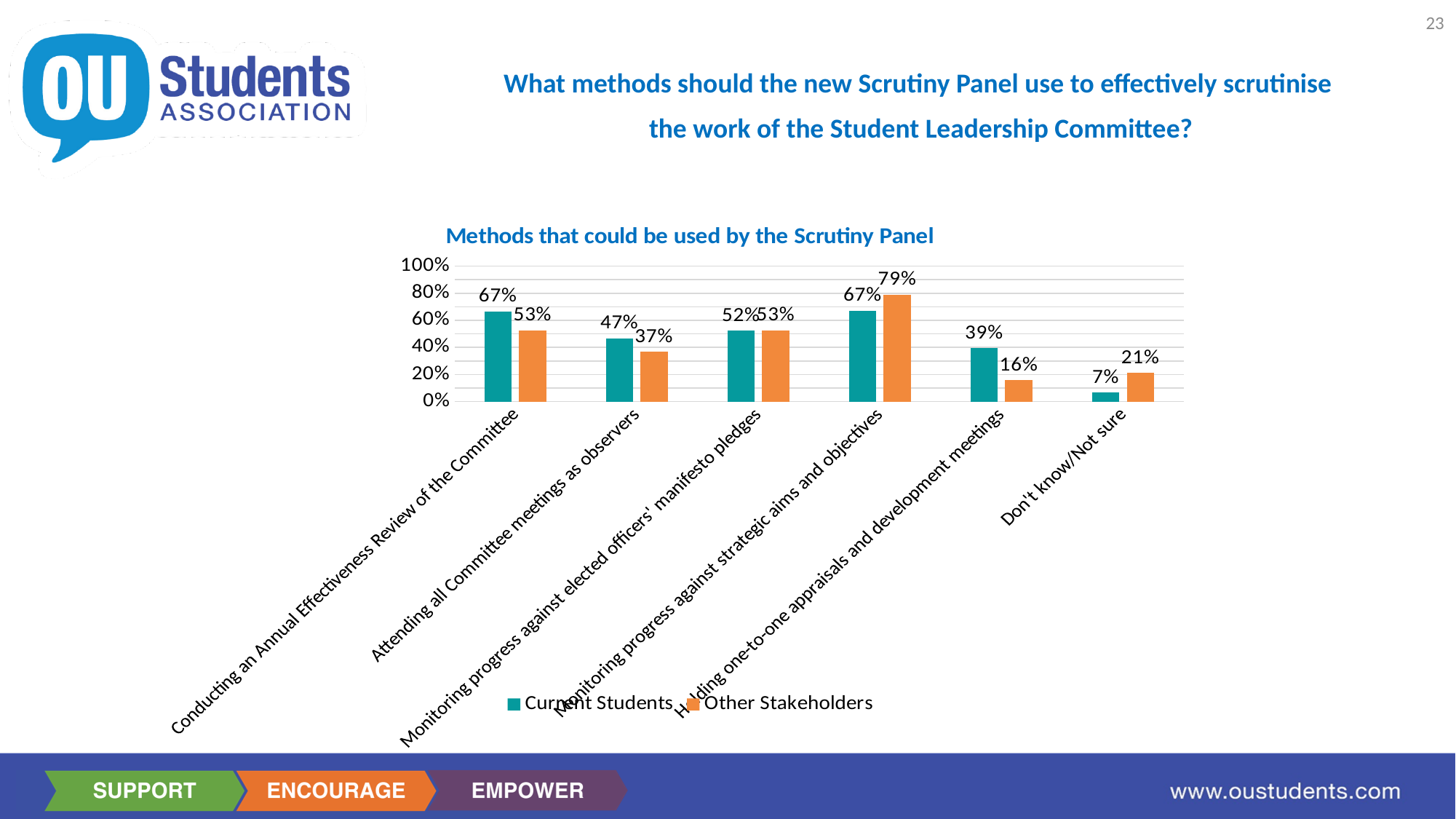
For 'Conducting an Annual Effectiveness Review of the Committee', which group has the higher value, Current Students or Other Stakeholders? Current Students What is the difference between Current Students and Other Stakeholders for 'Holding one-to-one appraisals and development meetings'? 23% Which category has the lowest value for Current Students? Don't know/Not sure What type of chart is shown on the slide? Bar chart What is the title of the chart? Methods that could be used by the Scrutiny Panel How many series does the chart legend list? 2 What is the Other Stakeholders value for 'Don't know/Not sure'? 21% What is the difference between Other Stakeholders and Current Students for 'Monitoring progress against strategic aims and objectives'? 12% What percentage of Other Stakeholders chose 'Holding one-to-one appraisals and development meetings'? 16% What percentage of Current Students chose 'Attending all Committee meetings as observers'? 47% How many methods (categories) are shown on the x axis of the chart? 6 Which method has the highest value among Other Stakeholders? Monitoring progress against strategic aims and objectives